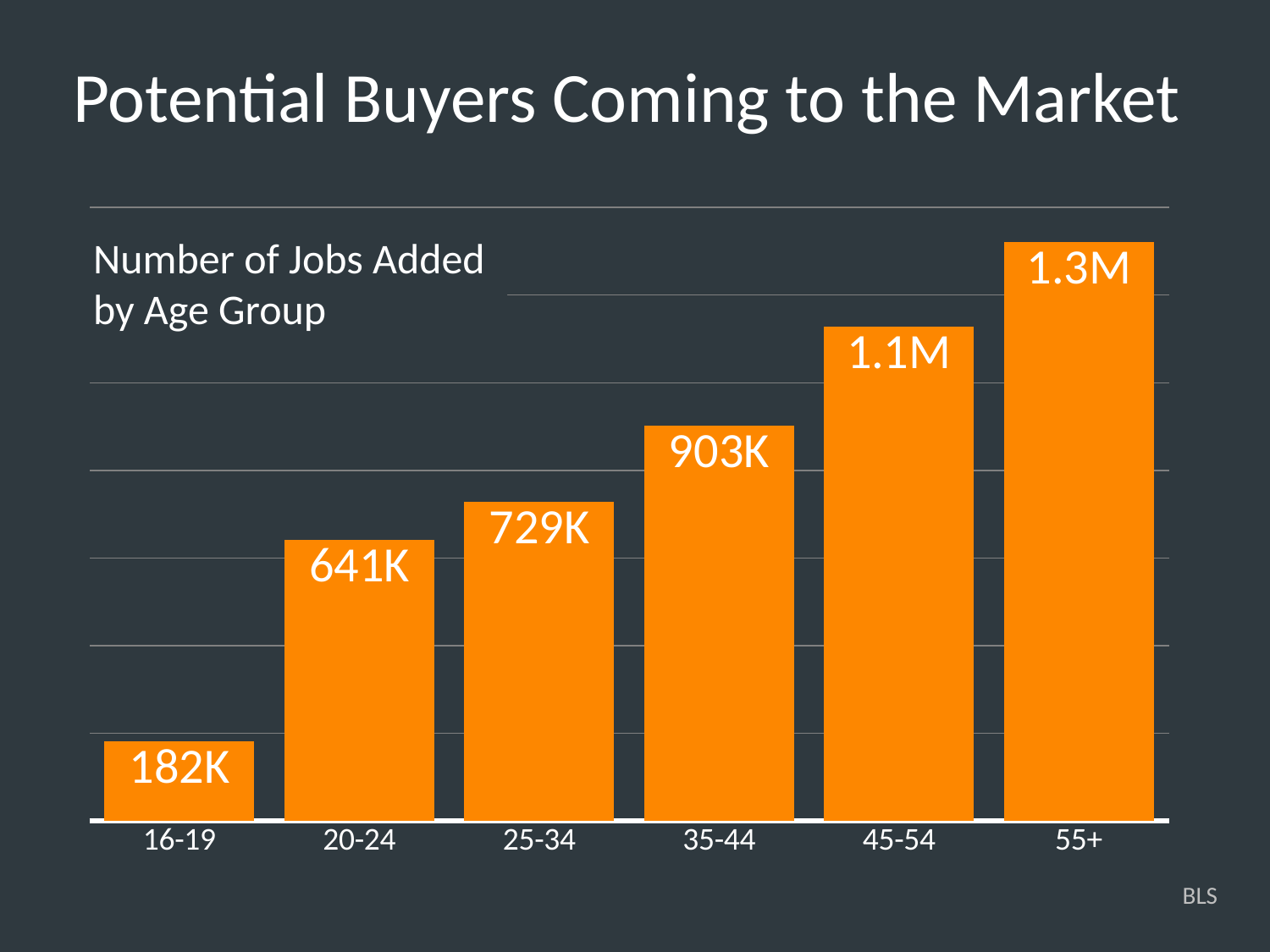
What is the title of the chart? Number of Jobs Added by Age Group Which age group has the highest number of jobs added? 55+ What is the number of jobs added for the 55+ age group? 1.3M What is the number of jobs added for the 16-19 age group? 182K What is the number of jobs added for the 35-44 age group? 903K What is the number of jobs added for the 20-24 age group? 641K Do the values rise or fall as the age groups increase from left to right? Rise How many age groups are shown in the chart? 6 What is the difference in jobs added between the 35-44 and 25-34 age groups? 174K Which age group has more jobs added, 20-24 or 45-54? 45-54 What kind of chart is shown on the slide? Bar chart Which age group has the lowest number of jobs added? 16-19